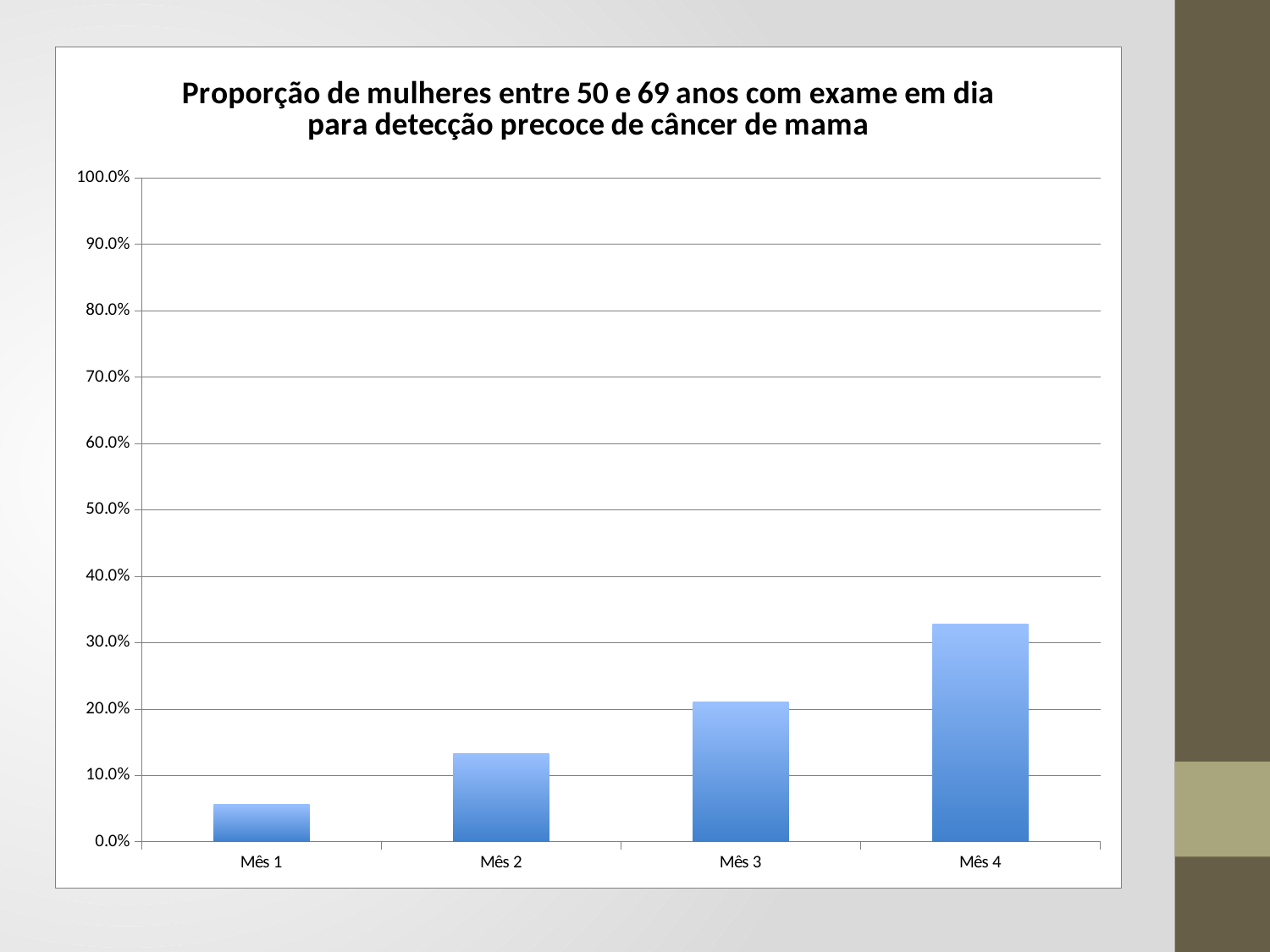
Which month has the highest value on the chart? Mês 4 Is the value for Mês 2 greater or less than 10.0%? greater Is the value for Mês 4 greater or less than 30.0%? greater Is the value for Mês 1 greater or less than 10.0%? less How many categories (months) are plotted on the chart? 4 What is the title of the chart? Proporção de mulheres entre 50 e 69 anos com exame em dia para detecção precoce de câncer de mama What kind of chart is shown on the slide? bar chart Which month has the lowest value on the chart? Mês 1 Which is larger, the value for Mês 2 or the value for Mês 3? Mês 3 Do the values rise or fall from Mês 1 to Mês 4? rise